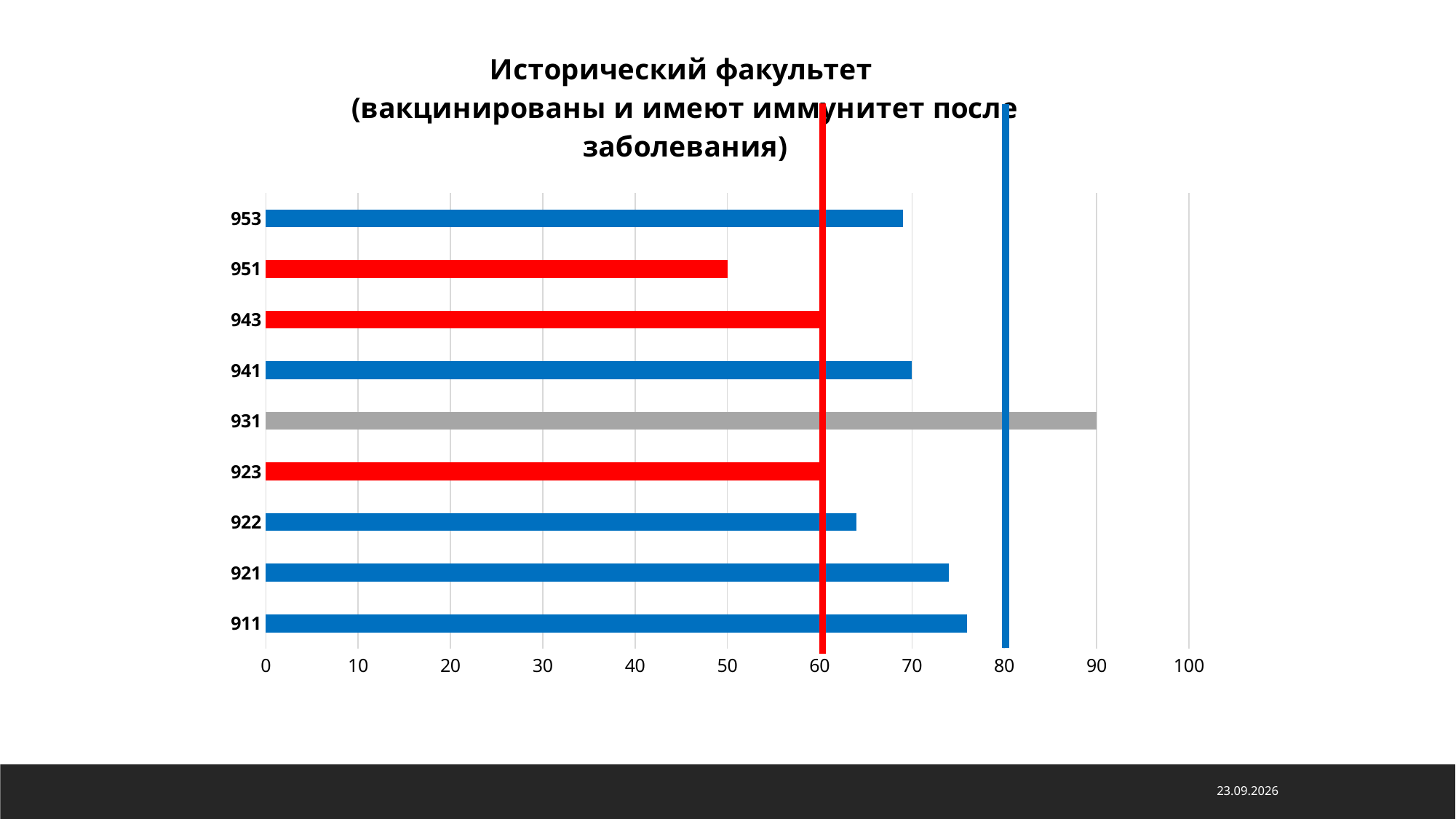
What is the value for group 923? 60 What colour is the bar for group 931? grey Which group has the lowest value? 951 Is the value for group 921 greater or less than 80? less What is the value for group 941? 70 What kind of chart is shown on the slide? bar chart Which group has the highest value? 931 Which group has the larger value, 911 or 922? 911 What is the value for group 951? 50 What is the difference between the values for groups 931 and 951? 40 What is the value for group 931? 90 How many groups (categories) are plotted on the chart? 9